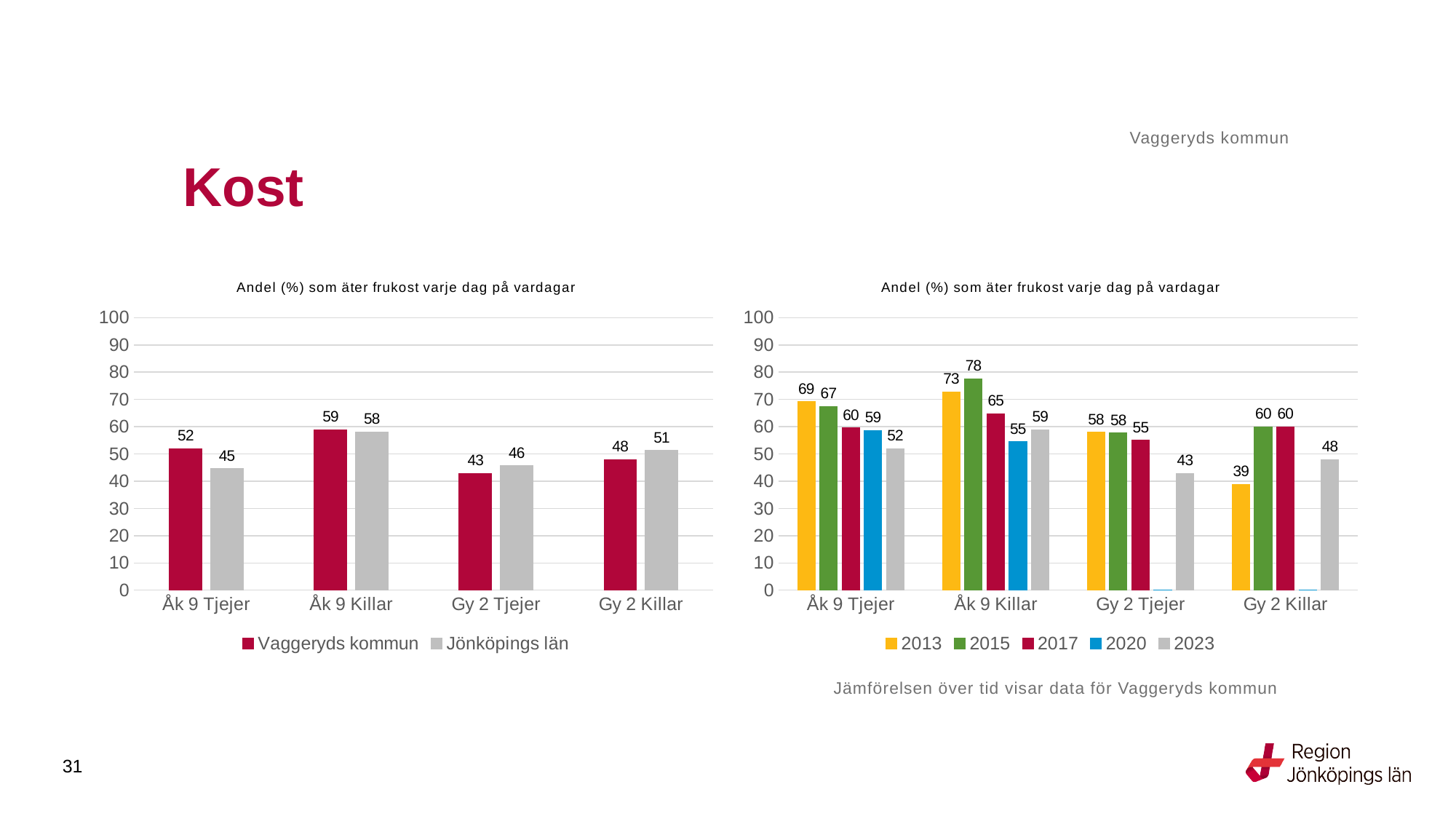
What type of chart is the right chart? Bar chart In the right chart, what is the value for 2013 for Gy 2 Killar? 39 In the left chart, which is larger for Gy 2 Killar: Vaggeryds kommun or Jönköpings län? Jönköpings län In the left chart, which category has the lowest value for Vaggeryds kommun? Gy 2 Tjejer In the left chart, what is the difference between Vaggeryds kommun and Jönköpings län for Åk 9 Tjejer? 7 In the right chart, which year has the highest value for Åk 9 Tjejer? 2013 How many series does the legend of the right chart list? 5 In the right chart, what is the difference between the 2013 and 2023 values for Åk 9 Tjejer? 17 In the left chart, what is the value for Jönköpings län for Gy 2 Tjejer? 46 In the left chart, what is the value for Vaggeryds kommun for Åk 9 Killar? 59 In the right chart, what is the value for 2015 for Åk 9 Killar? 78 How many series does the legend of the left chart list? 2